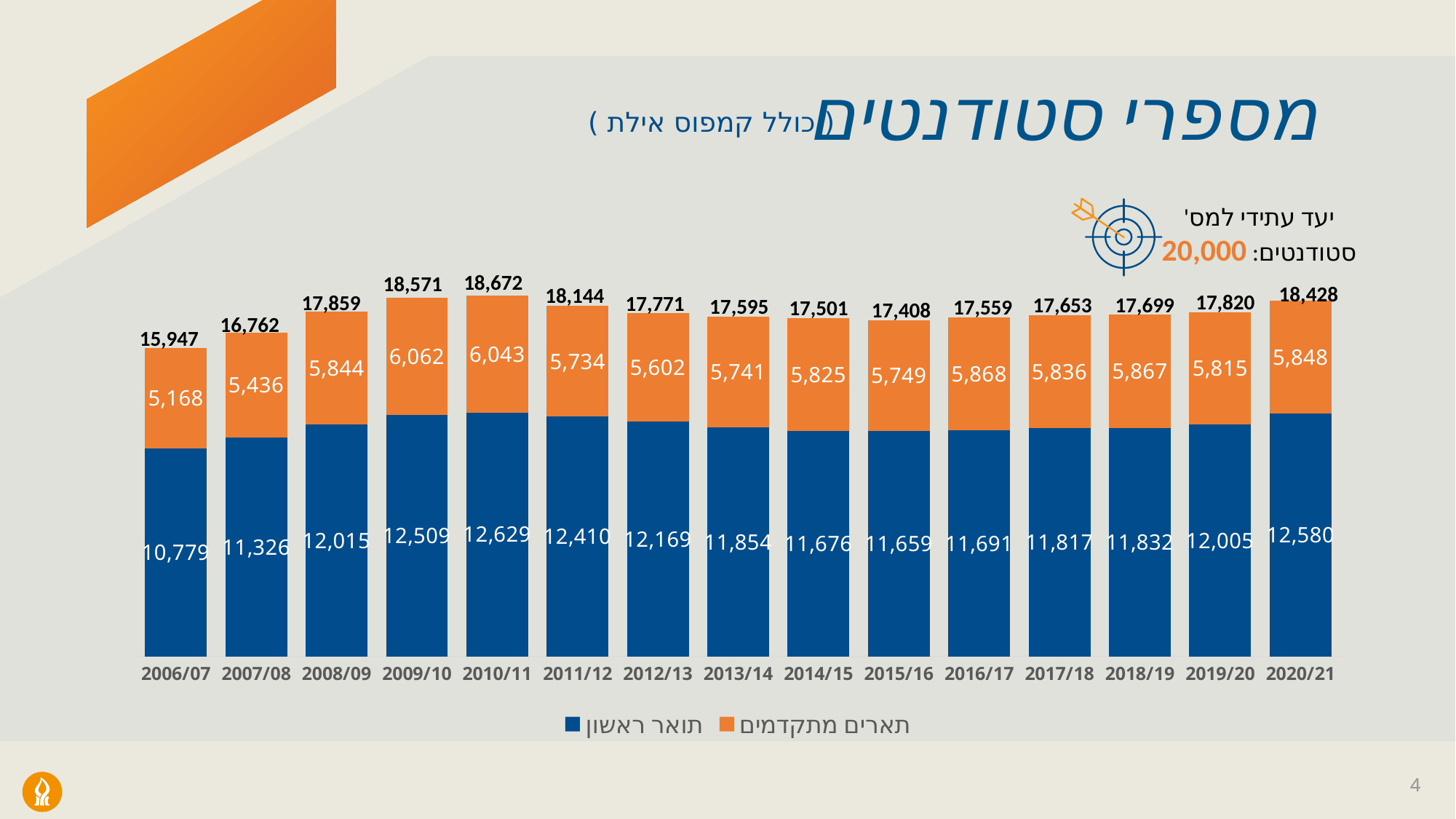
How many series does the legend list? 2 What is the value for תארים מתקדמים (advanced degrees) in 2020/21? 5,848 What is the value for תואר ראשון (first degree) in 2006/07? 10,779 What is the total number of students shown for 2010/11? 18,672 How many academic years are shown on the x axis? 15 Which year has the lowest total number of students? 2006/07 What future target number of students is stated on the slide? 20,000 Which is larger: the תואר ראשון value in 2009/10 or in 2013/14? 2009/10 Which year has the highest total number of students? 2010/11 Which series is shown in orange? תארים מתקדמים What kind of chart is shown on the slide? Stacked bar chart What is the difference between the total for 2020/21 and the total for 2019/20? 608